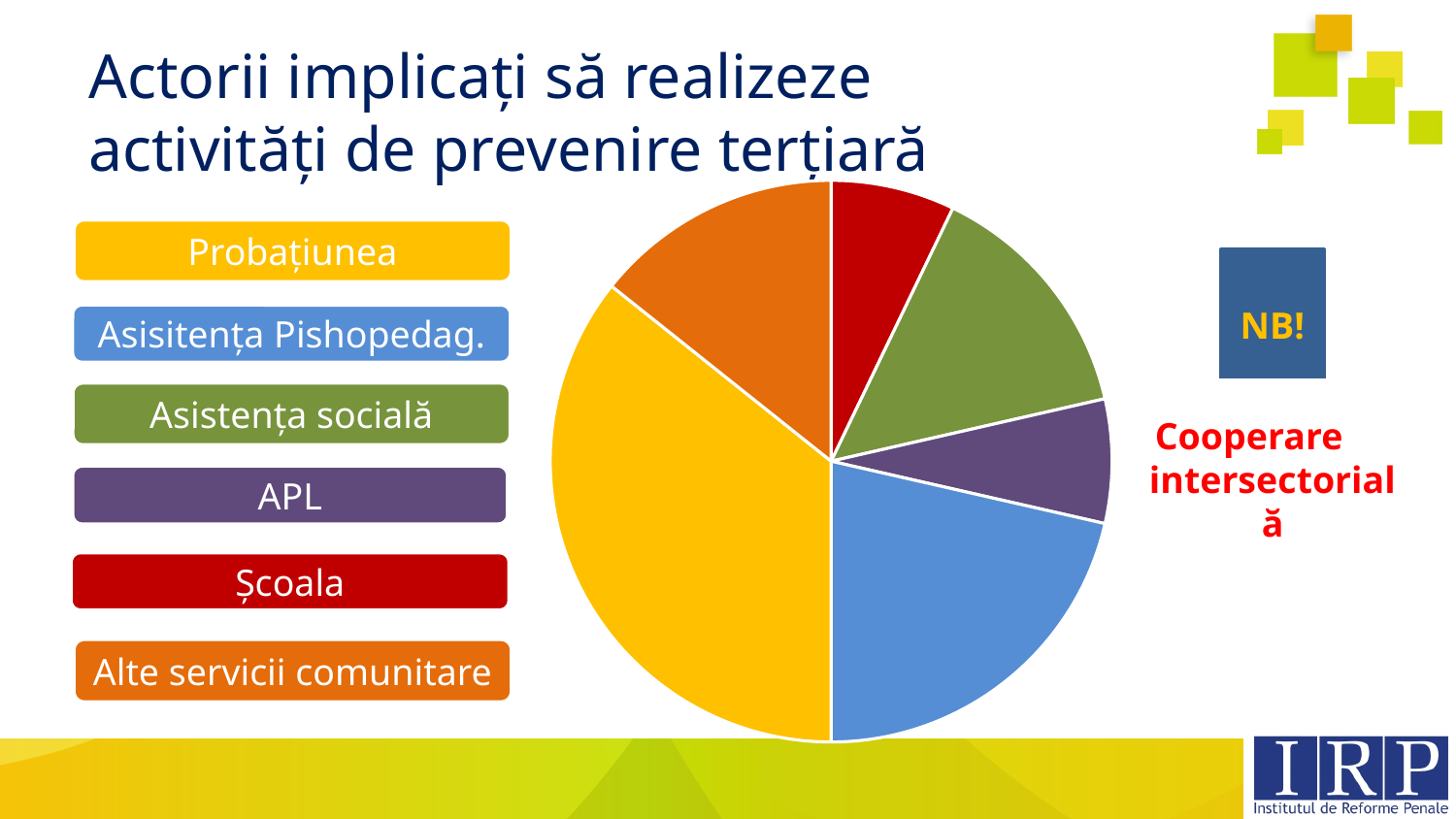
Which slice is larger, Asistența socială or APL? Asistența socială Which slice is larger, Alte servicii comunitare or APL? Alte servicii comunitare Which slice is larger, Asisitența Pishopedag. or Școala? Asisitența Pishopedag. What kind of chart is shown on the slide? pie chart What colour is the slice for Probațiunea? yellow How many categories are listed in the legend boxes on the left of the slide? 6 Which category has the largest slice of the pie chart? Probațiunea How many slices does the pie chart have? 6 What is the title of the slide containing the pie chart? Actorii implicați să realizeze activități de prevenire terțiară